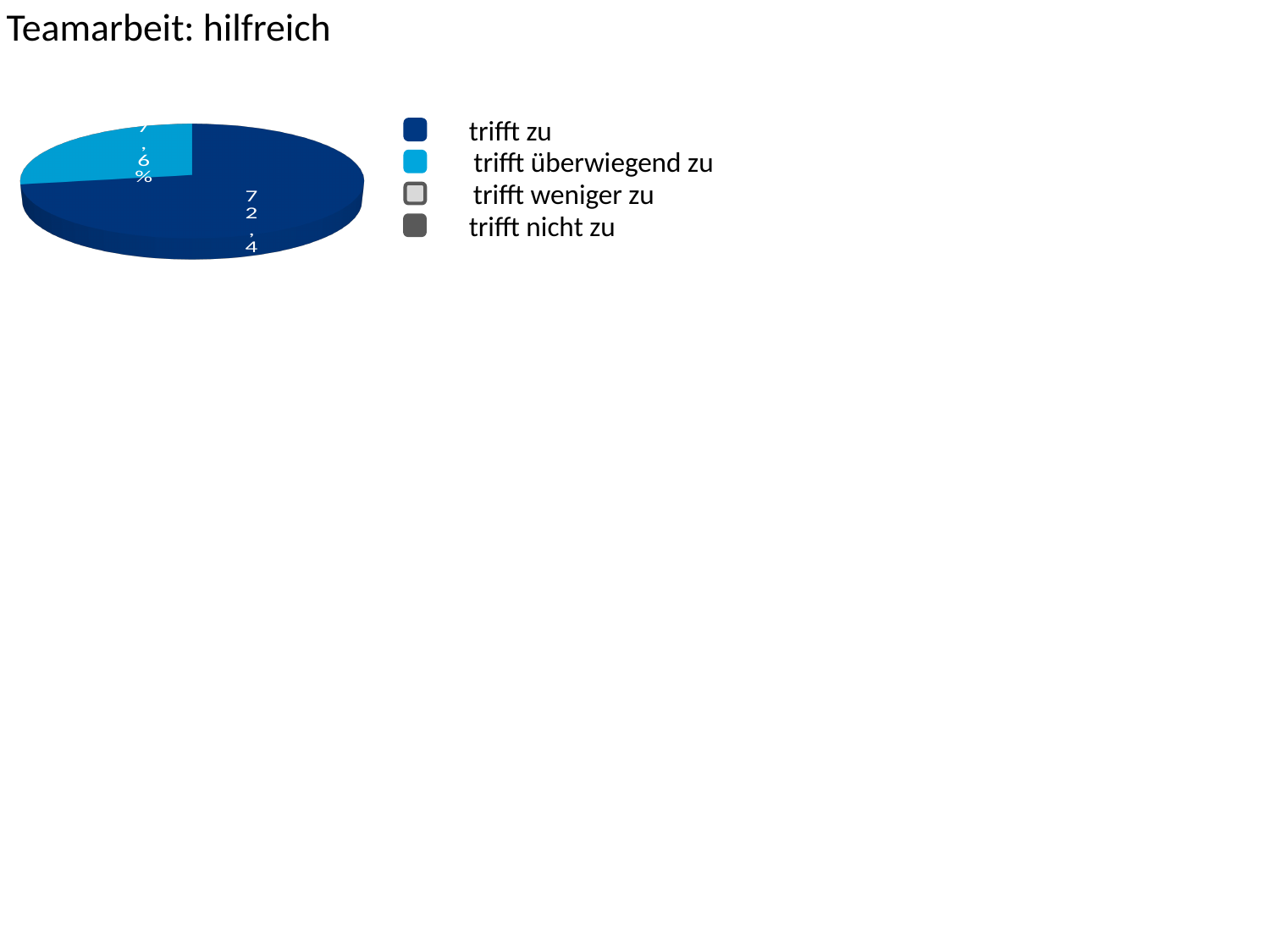
Is the share for trifft überwiegend zu greater or less than 50%? less How many slices are visible in the pie? 2 How many entries does the legend list? 4 Is the share for trifft zu greater or less than 50%? greater Which category has the largest slice of the pie? trifft zu Which slice is larger, trifft zu or trifft überwiegend zu? trifft zu Which legend entry is shown in light blue? trifft überwiegend zu What kind of chart is shown on the slide? pie chart Which of the two visible slices is smaller, trifft zu or trifft überwiegend zu? trifft überwiegend zu What is the title of the chart? Teamarbeit: hilfreich